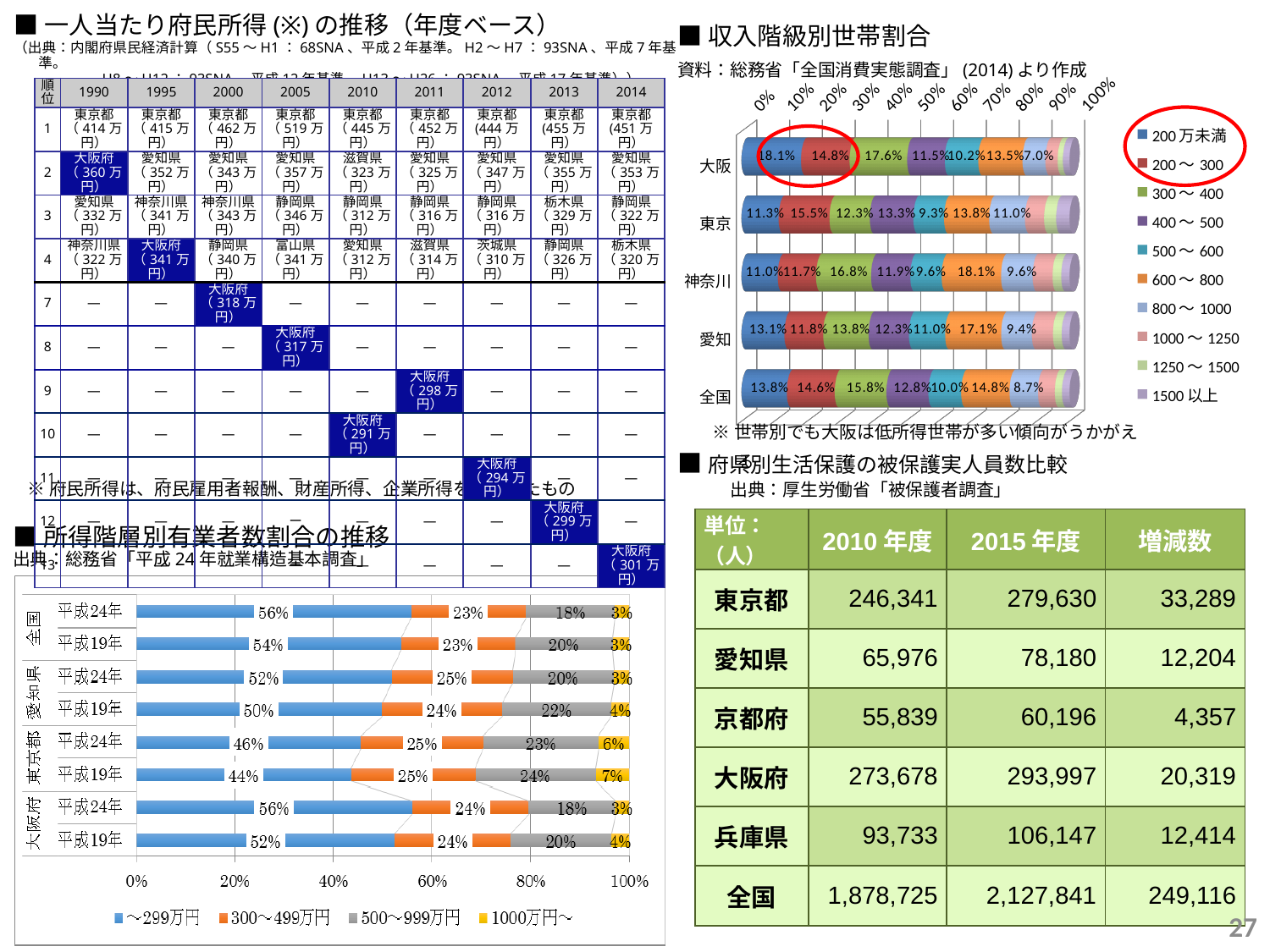
In the 所得階層別有業者数割合の推移 chart, what is the difference between the ～299万円 share for 大阪府 in 平成24年 and in 平成19年? 4% In the 収入階級別世帯割合 chart, how many series does the legend list? 10 In the 収入階級別世帯割合 chart, what is the value of the 200～300 segment for 東京? 15.5% In the 収入階級別世帯割合 chart, which is larger: the 600～800 share for 神奈川 or for 愛知? 神奈川 What kind of chart is the 所得階層別有業者数割合の推移 chart? Stacked bar chart In the 収入階級別世帯割合 chart, what is the value of the 200万未満 segment for 大阪? 18.1% In the 所得階層別有業者数割合の推移 chart, what is the 1000万円～ share for 東京都 in 平成19年? 7% In the 所得階層別有業者数割合の推移 chart, what is the ～299万円 share for 東京都 in 平成24年? 46% In the 収入階級別世帯割合 chart, what is the difference between the 200万未満 share for 大阪 and for 全国? 4.3% In the 所得階層別有業者数割合の推移 chart, how many bars are plotted? 8 In the 所得階層別有業者数割合の推移 chart, how many series does the legend list? 4 In the 収入階級別世帯割合 chart, which prefecture has the highest 200万未満 share? 大阪